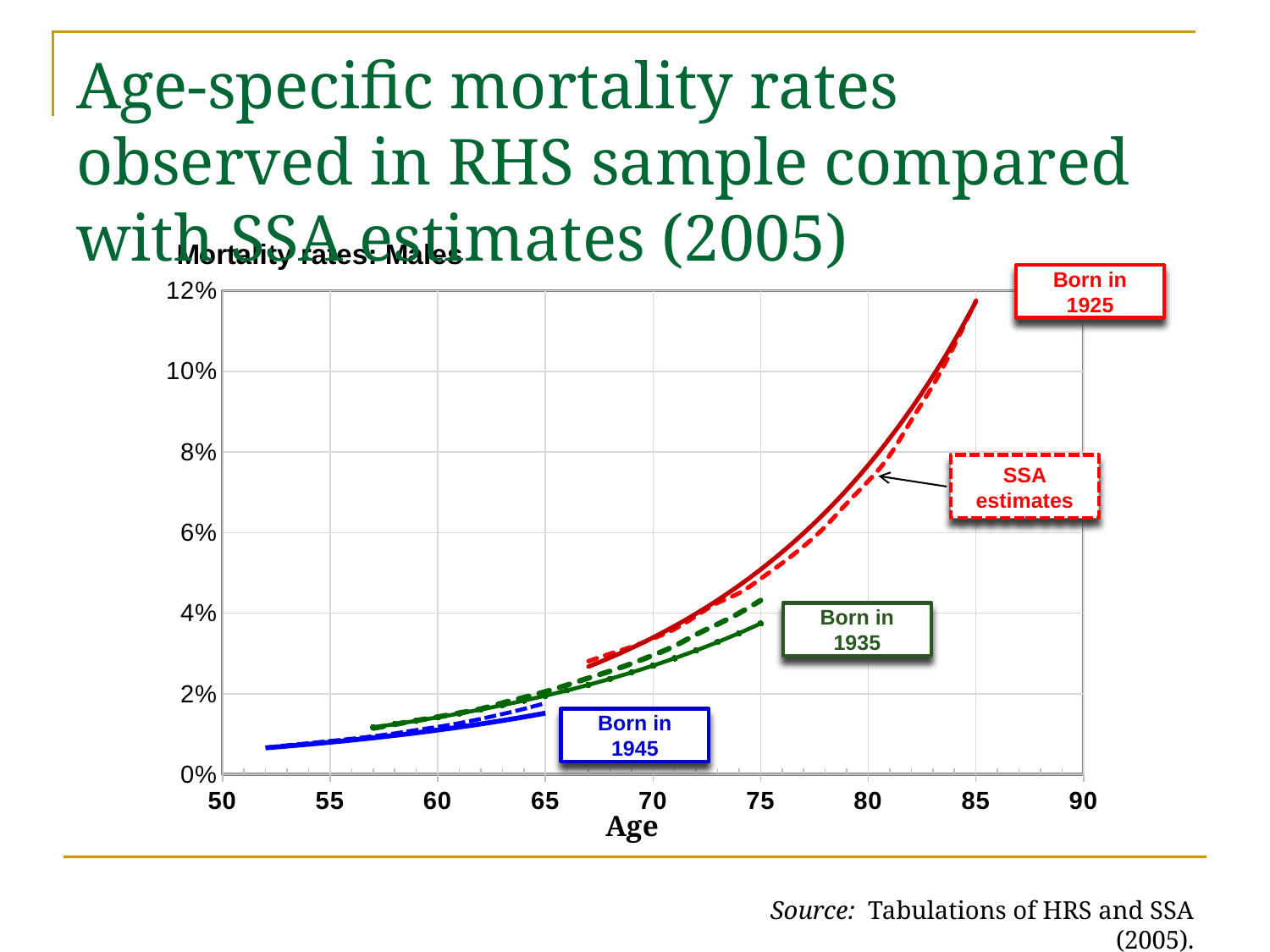
Is the mortality rate for the Born in 1925 cohort at age 70 greater or less than 6%? less Is the mortality rate for the Born in 1935 cohort at age 75 greater or less than 2%? greater How many birth cohorts are labelled on the chart? 3 Do mortality rates rise or fall as age increases along the x axis? Rise Which is larger: the mortality rate of the Born in 1925 cohort at age 85 or the Born in 1935 cohort at age 75? Born in 1925 at age 85 What kind of chart is shown on the slide? Line chart Which birth cohort reaches the highest mortality rate on the chart? Born in 1925 Is the mortality rate for the Born in 1945 cohort at age 55 greater or less than 2%? less What is the title of the chart? Mortality rates: Males What is the label of the x axis? Age Which birth cohort has the lowest mortality rates on the chart? Born in 1945